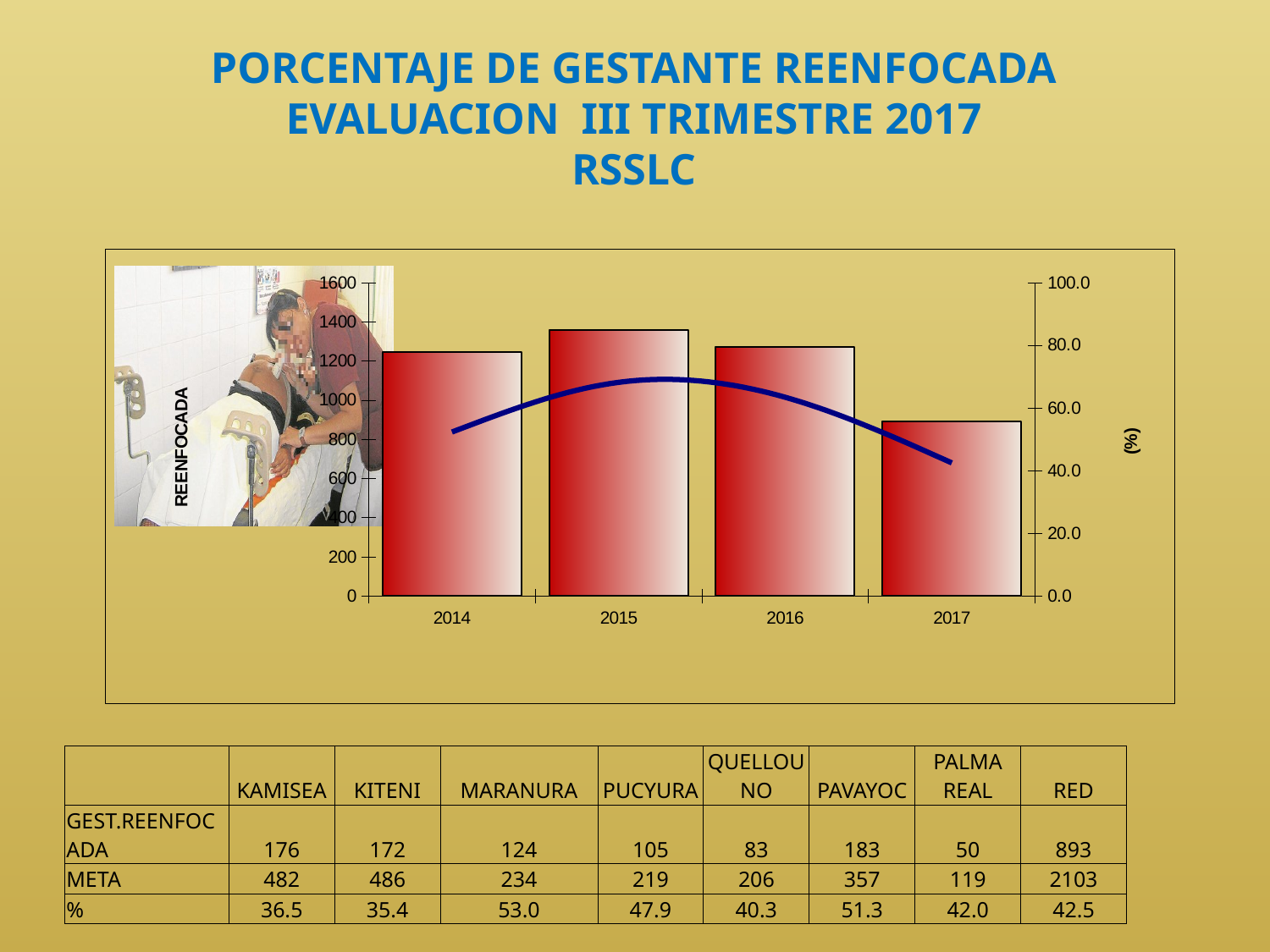
Which year has the shortest bar in the chart? 2017 How many years are shown on the x axis of the chart? 4 Does the line in the chart rise or fall between 2016 and 2017? Fall Is the bar for 2017 greater or less than 1000 on the left axis? less Is the bar for 2015 greater or less than 1200 on the left axis? greater Which year has the tallest bar in the chart? 2015 What kind of chart is shown on the slide? Bar chart with a line Which bar is taller, 2014 or 2015? 2015 What is the highest tick value on the right-hand axis of the chart? 100.0 Is the bar for 2014 greater or less than 1000 on the left axis? greater Which bar is taller, 2016 or 2017? 2016